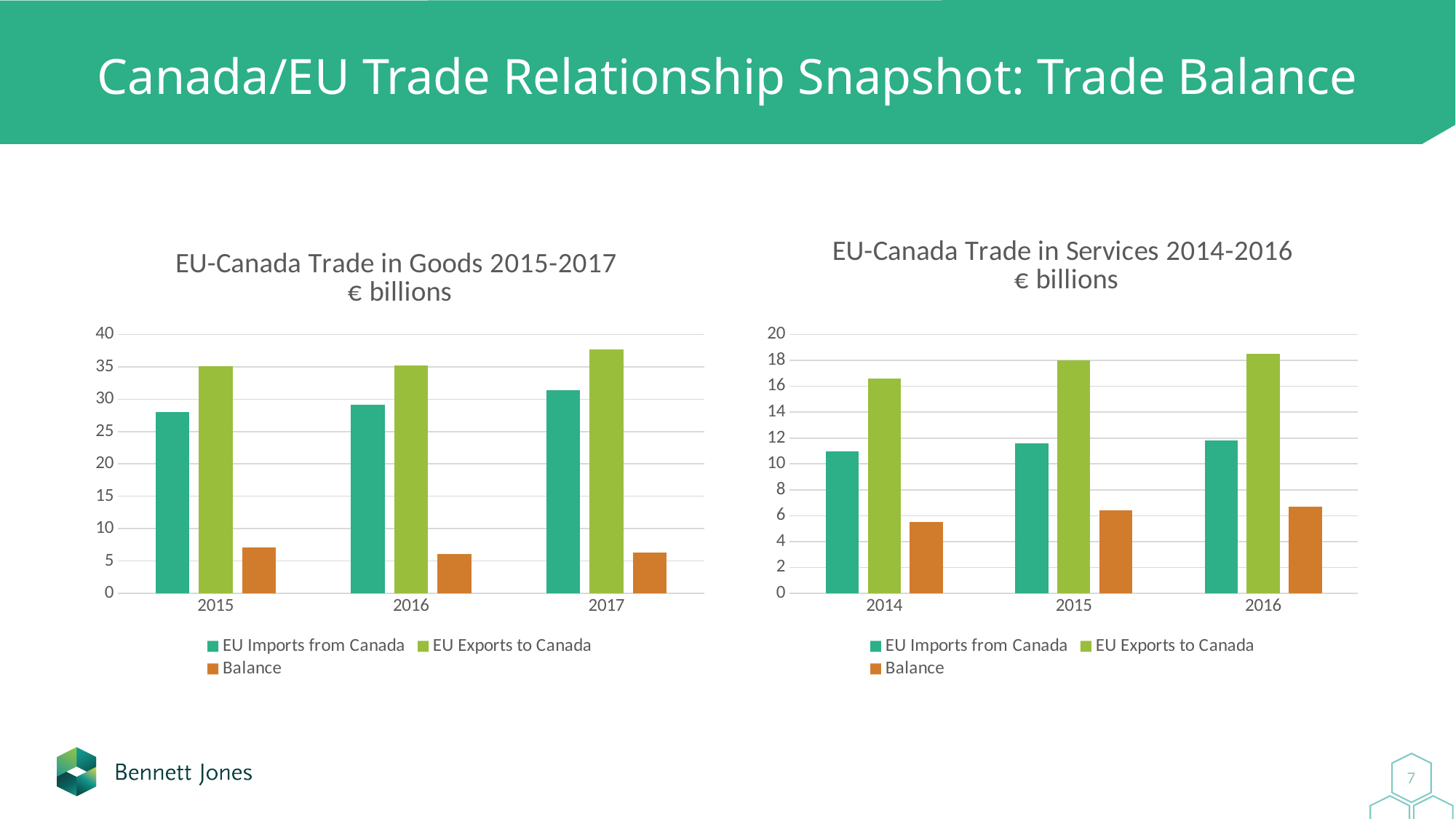
In the 'EU-Canada Trade in Goods 2015-2017' chart, is the value for EU Imports from Canada in 2015 greater or less than 30? less How many years are shown on the x axis of the 'EU-Canada Trade in Services 2014-2016' chart? 3 In the 'EU-Canada Trade in Goods 2015-2017' chart, do the values for EU Imports from Canada rise or fall from 2015 to 2017? rise In the 'EU-Canada Trade in Services 2014-2016' chart, which is larger in 2016: EU Imports from Canada or EU Exports to Canada? EU Exports to Canada How many series does the legend of the 'EU-Canada Trade in Goods 2015-2017' chart list? 3 What kind of chart is the 'EU-Canada Trade in Goods 2015-2017' chart on the left? bar chart What unit is stated in the title of the chart on the right? € billions In the 'EU-Canada Trade in Services 2014-2016' chart, do the values for EU Exports to Canada rise or fall from 2014 to 2016? rise In the 'EU-Canada Trade in Services 2014-2016' chart, is the value for EU Exports to Canada in 2014 greater or less than 15? greater In the 'EU-Canada Trade in Goods 2015-2017' chart, which year has the highest value for EU Exports to Canada? 2017 In the 'EU-Canada Trade in Goods 2015-2017' chart, is the value for EU Exports to Canada in 2017 greater or less than 35? greater In the 'EU-Canada Trade in Services 2014-2016' chart, which year has the lowest Balance? 2014